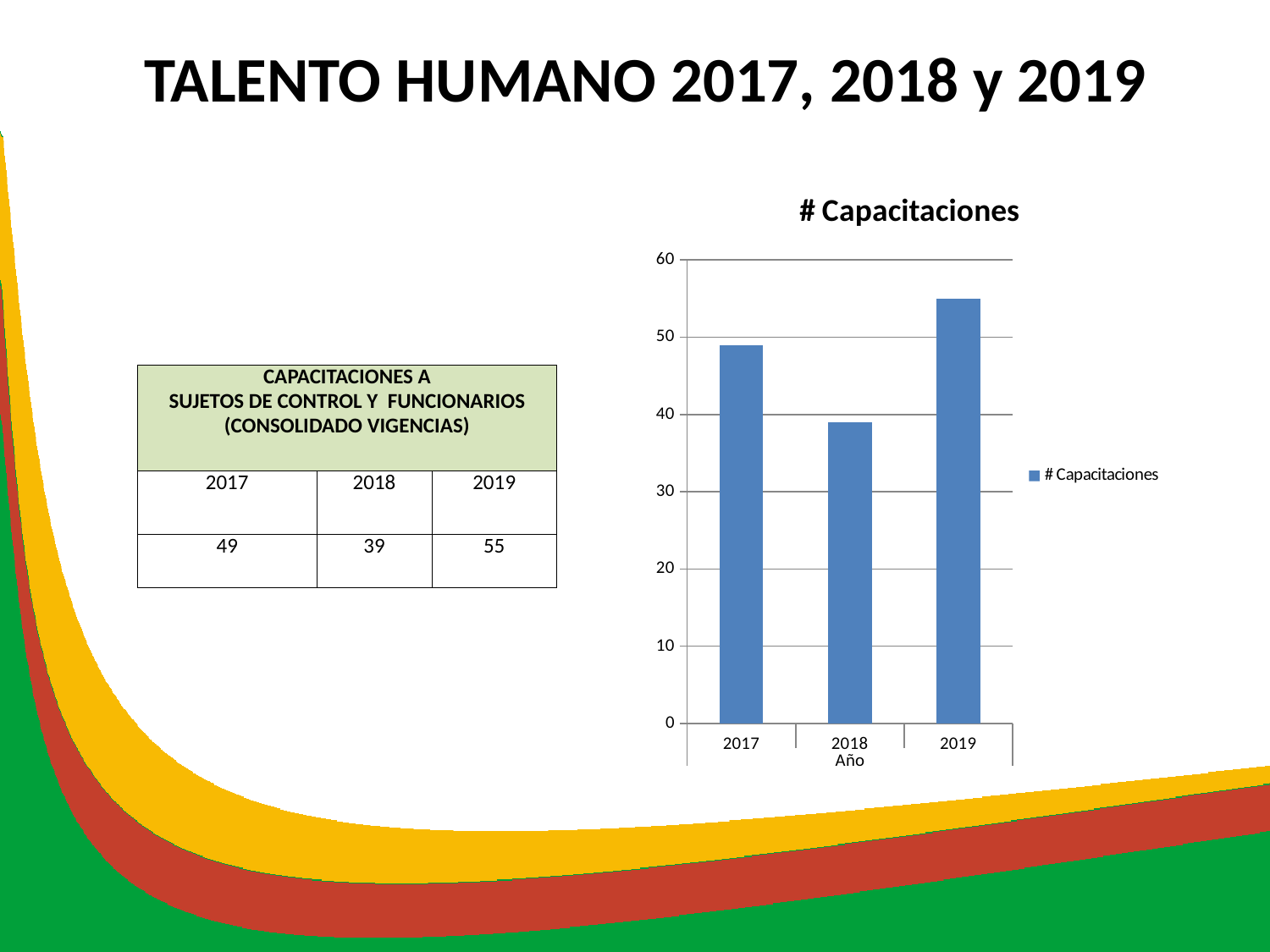
How many bars (years) are plotted in the chart? 3 Is the value for 2018 greater or less than 40? less Which is larger, the value for 2017 or the value for 2018? 2017 What is the title of the chart? # Capacitaciones According to the slide, how many capacitaciones were there in 2019? 55 What kind of chart is shown on the slide? bar chart Which year has the highest number of capacitaciones in the chart? 2019 Is the value for 2017 greater or less than 40? greater Which year has the lowest number of capacitaciones in the chart? 2018 How many series does the chart legend list? 1 What is the label of the x axis of the chart? Año Is the value for 2019 greater or less than 50? greater